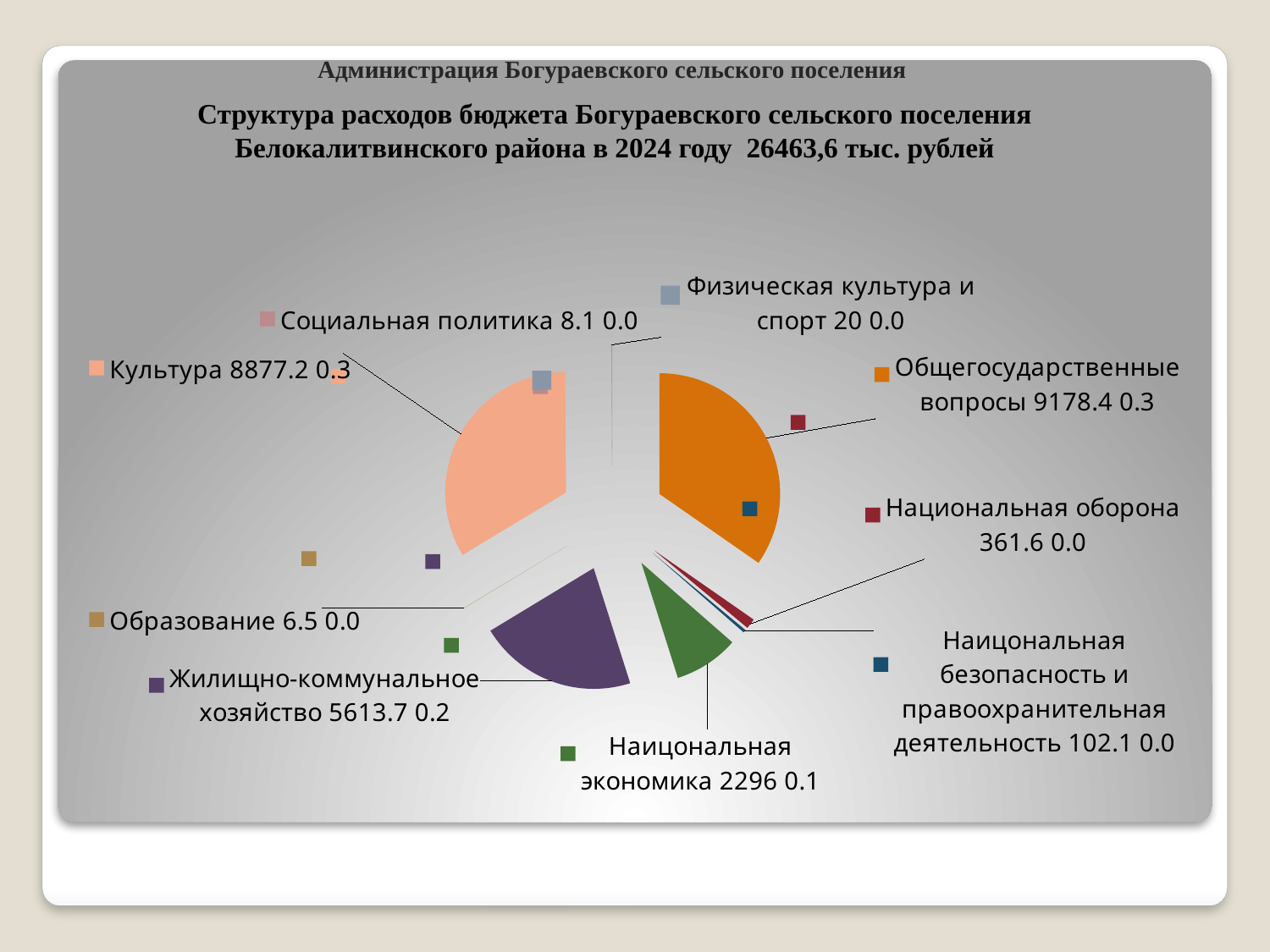
How many categories does the pie chart show? 9 Which category has the highest value? Общегосударственные вопросы What total budget expenditure amount is stated in the chart title? 26463,6 тыс. рублей Which category has the lowest value? Образование What is the value for Национальная оборона? 361.6 What is the value for Жилищно-коммунальное хозяйство? 5613.7 What is the value for Общегосударственные вопросы? 9178.4 Which is larger, the value for Наицональная экономика or the value for Жилищно-коммунальное хозяйство? Жилищно-коммунальное хозяйство What share of the pie is labelled for Жилищно-коммунальное хозяйство? 0.2 What kind of chart is shown on the slide? pie chart What is the value for Культура? 8877.2 What is the difference between the values for Общегосударственные вопросы and Культура? 301.2